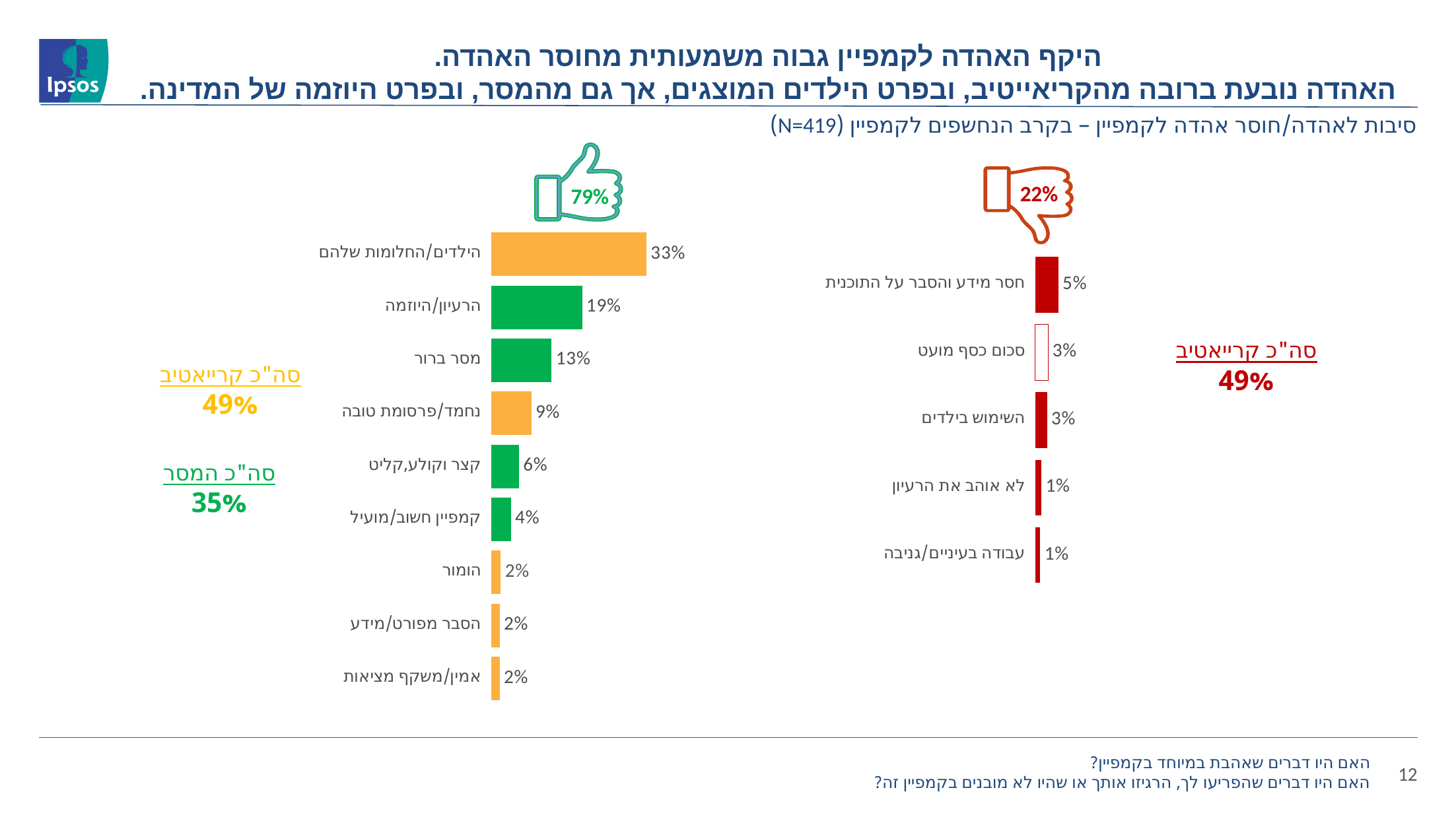
In the left chart (thumbs up), which is larger: נחמד/פרסומת טובה or קצר וקולע,קליט? נחמד/פרסומת טובה What percentage is shown next to the thumbs-down icon above the right chart? 22% What kind of chart is the right chart (thumbs down)? Bar chart In the left chart (thumbs up), which category has the highest value? הילדים/החלומות שלהם In the left chart (thumbs up), what is the value for מסר ברור? 13% How many categories are shown in the left chart (thumbs up)? 9 In the right chart (thumbs down), which category has the highest value? חסר מידע והסבר על התוכנית In the left chart (thumbs up), what is the difference between הילדים/החלומות שלהם and הרעיון/היוזמה? 14% What percentage is shown next to the thumbs-up icon above the left chart? 79% In the right chart (thumbs down), what is the value for חסר מידע והסבר על התוכנית? 5% In the left chart (thumbs up), what is the value for הילדים/החלומות שלהם? 33% How many categories are shown in the right chart (thumbs down)? 5